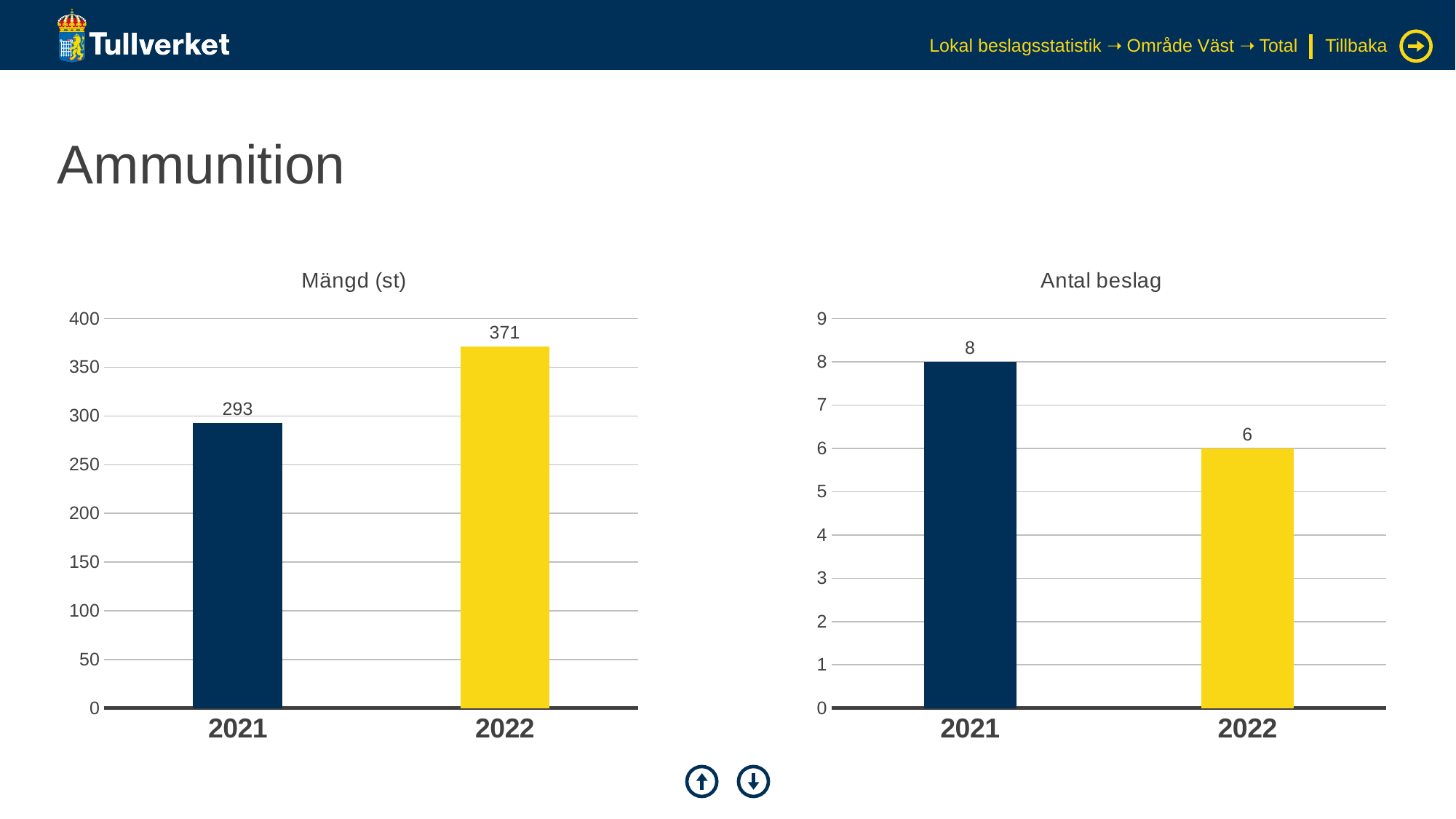
What kind of chart is the "Antal beslag" chart? bar chart In the "Mängd (st)" chart, what is the value for 2022? 371 In the "Mängd (st)" chart, is the value for 2021 greater or less than 300? less In the "Mängd (st)" chart, what is the difference between the 2022 and 2021 values? 78 In the "Antal beslag" chart, is the value for 2021 larger or smaller than the value for 2022? larger In the "Antal beslag" chart, which year has the lowest value? 2022 In the "Mängd (st)" chart, which year has the highest value? 2022 How many bars does the "Mängd (st)" chart show? 2 In the "Mängd (st)" chart, what is the value for 2021? 293 In the "Antal beslag" chart, what is the difference between the 2021 and 2022 values? 2 In the "Antal beslag" chart, what is the value for 2021? 8 In the "Antal beslag" chart, what is the value for 2022? 6